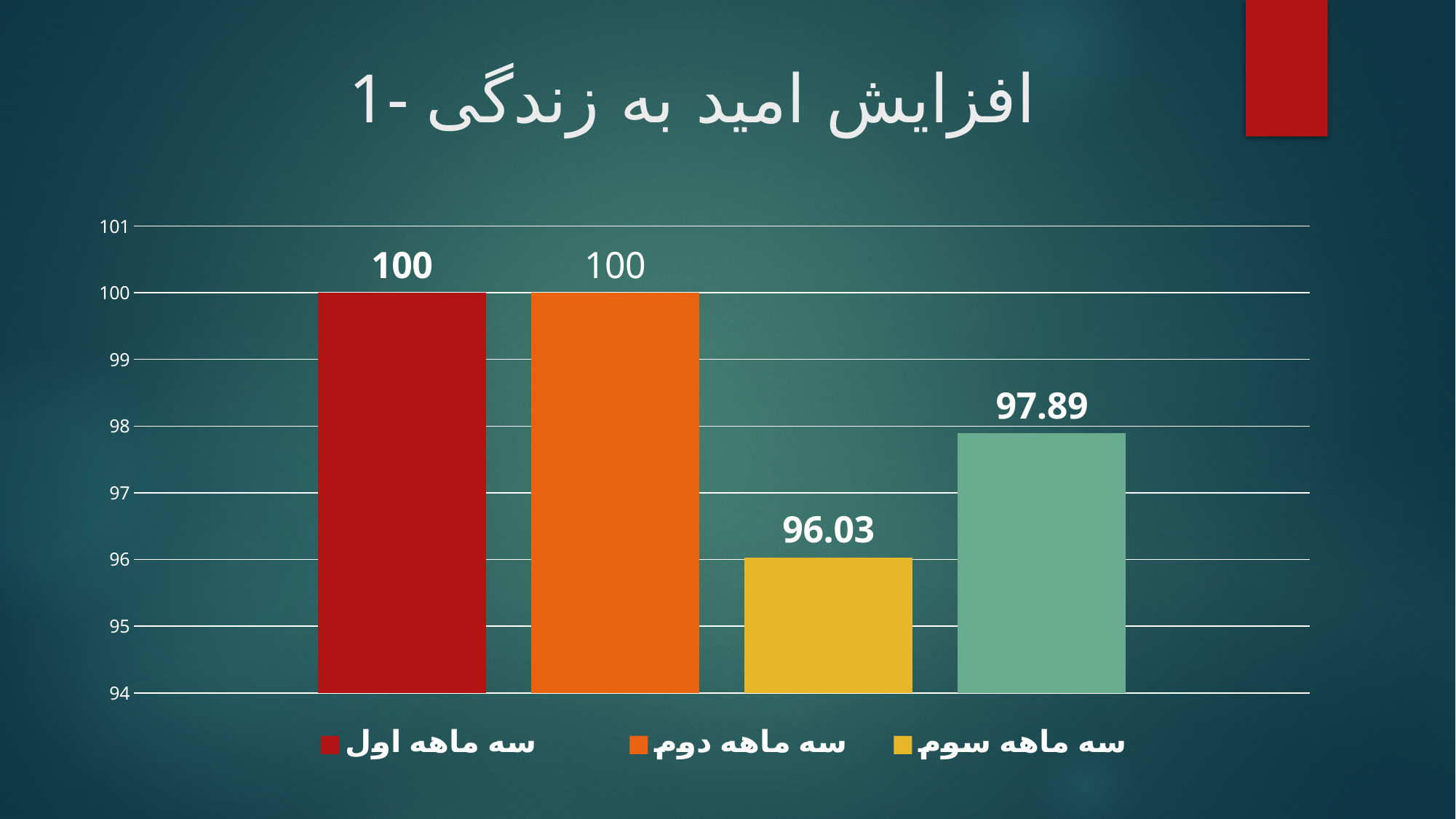
Is the value for سه ماهه سوم greater or less than 97? less What is the difference between the rightmost (teal) bar and the value for سه ماهه سوم? 1.86 What is the value for سه ماهه سوم? 96.03 What is the difference between the value for سه ماهه اول and the value for سه ماهه سوم? 3.97 What is the value for سه ماهه دوم? 100 How many bars are plotted in the chart? 4 What is the value shown on the rightmost (teal) bar? 97.89 Which is larger: the value for سه ماهه سوم or the value of the rightmost (teal) bar? the rightmost (teal) bar Which legend category has the lowest value? سه ماهه سوم What type of chart is shown on the slide? bar chart What is the value for سه ماهه اول? 100 How many entries does the legend list? 3